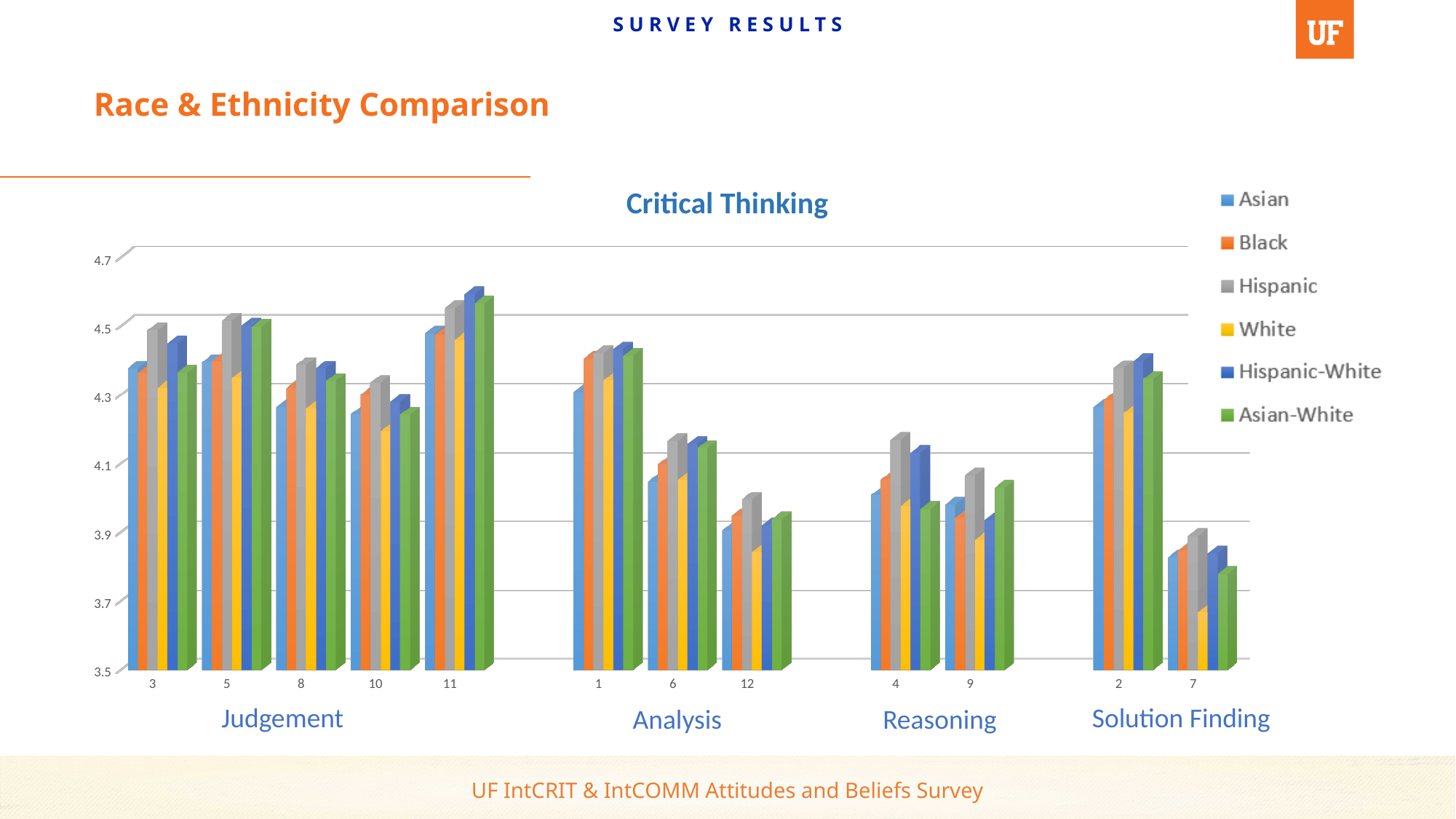
Within category 7, which series has the lowest value? White Is the Asian value for category 7 greater or less than 3.9? less Which numbered category has the lowest values overall? 7 Is the Asian-White value for category 9 greater or less than 4.1? less What kind of chart is shown on the slide? bar chart Which is larger: the Asian value for category 11 or the Asian value for category 7? category 11 How many numbered categories are plotted along the x axis? 12 How many series does the legend list? 6 Which colour represents the Asian-White series in the legend? green What is the title of the chart? Critical Thinking Is the Hispanic value for category 11 greater or less than 4.5? greater